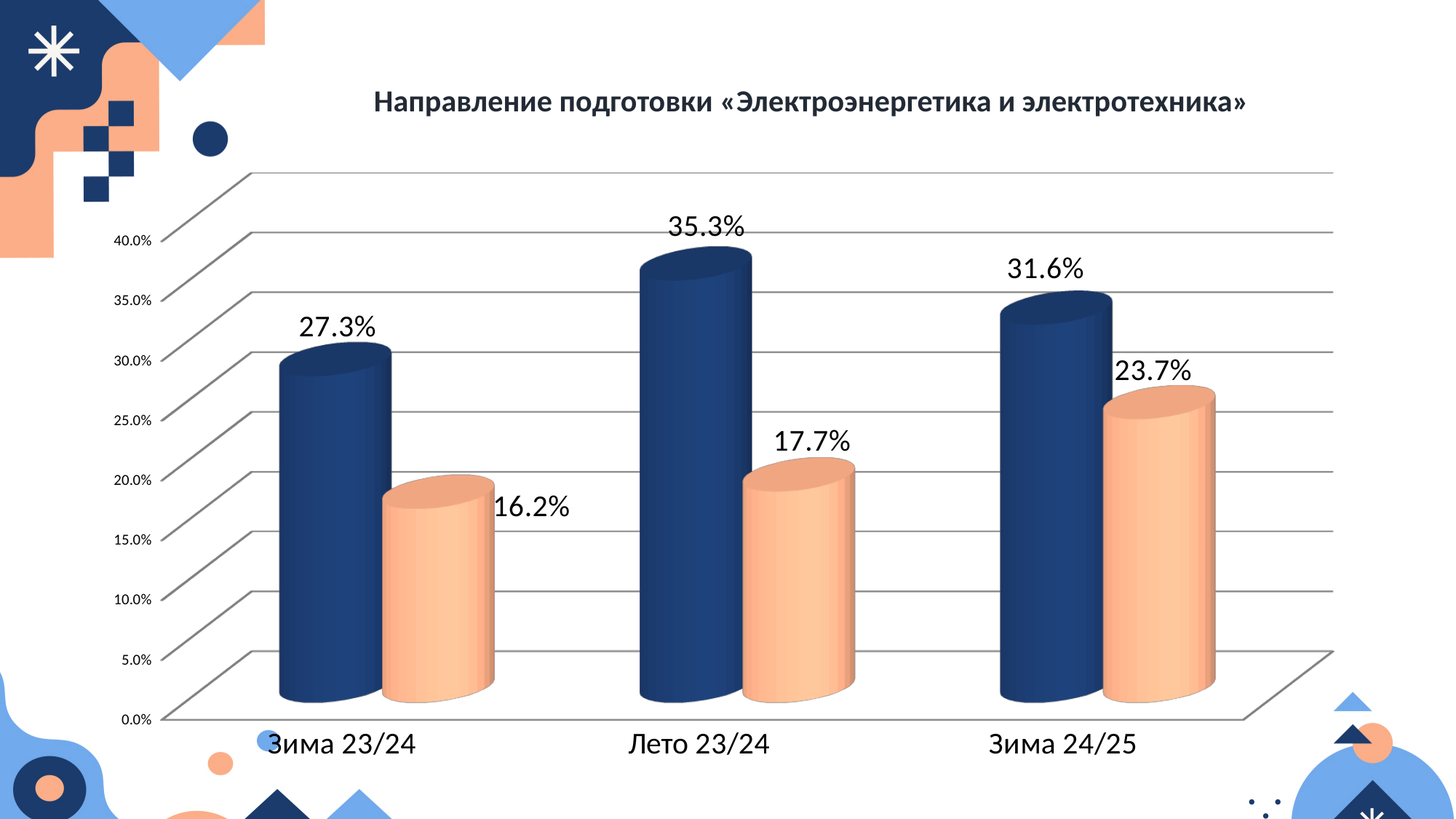
Which category has the lowest orange bar? Зима 23/24 How many categories are shown on the x axis? 3 What is the value of the orange bar for Зима 23/24? 16.2% Which category has the highest dark blue bar? Лето 23/24 What is the value of the orange bar for Зима 24/25? 23.7% What is the value of the dark blue bar for Зима 24/25? 31.6% What is the value of the dark blue bar for Лето 23/24? 35.3% Is the orange bar for Зима 24/25 greater or less than 20.0%? greater Which is larger: the dark blue bar for Зима 23/24 or the dark blue bar for Зима 24/25? Зима 24/25 What is the difference between the dark blue and orange bars for Лето 23/24? 17.6% What kind of chart is shown on the slide? bar chart Do the orange bars rise or fall from Зима 23/24 to Зима 24/25? rise